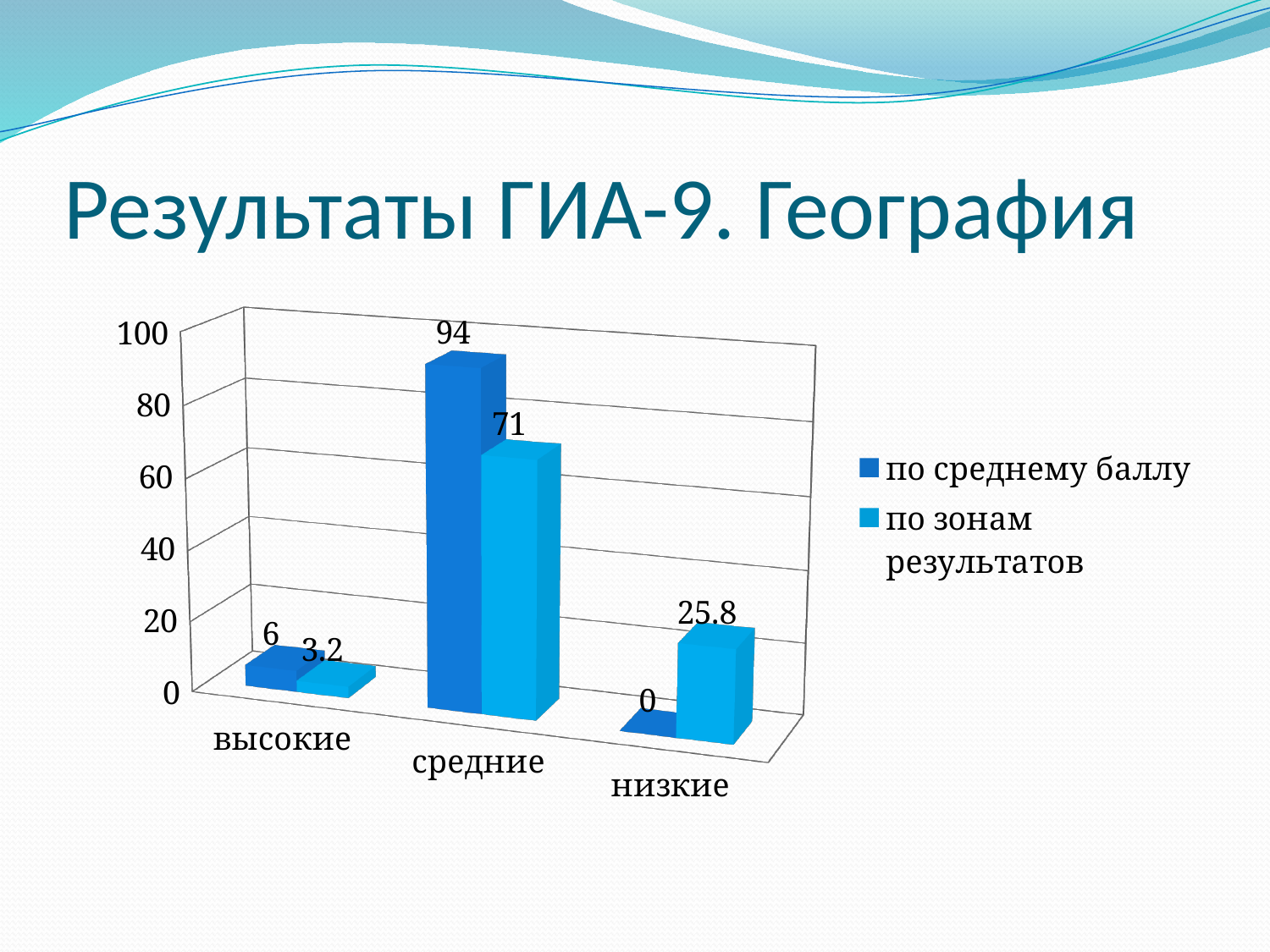
Which category has the highest value in the 'по среднему баллу' series? средние What is the value for 'высокие' in the 'по зонам результатов' series? 3.2 For 'высокие', which series has the larger value: 'по среднему баллу' or 'по зонам результатов'? по среднему баллу What kind of chart is shown on the slide? bar chart What is the value for 'низкие' in the 'по среднему баллу' series? 0 How many categories are shown on the x axis? 3 What is the value for 'средние' in the 'по среднему баллу' series? 94 What is the difference between the 'по среднему баллу' and 'по зонам результатов' values for 'средние'? 23 How many series does the legend list? 2 What is the title of the slide? Результаты ГИА-9. География Which category has the lowest value in the 'по зонам результатов' series? высокие What is the value for 'низкие' in the 'по зонам результатов' series? 25.8